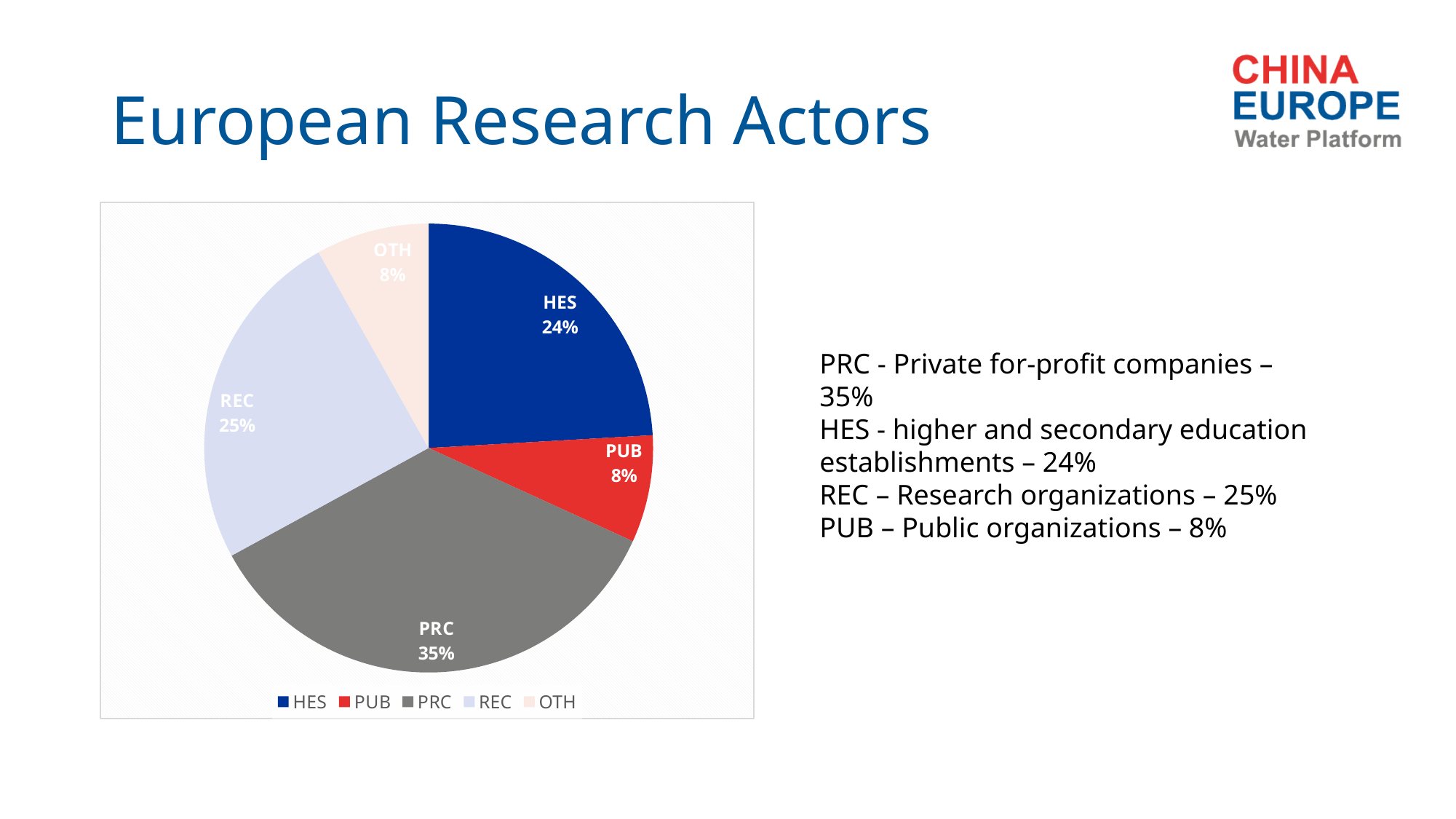
Which category has the largest slice of the pie? PRC What is the difference in percentage points between PRC and HES? 11 Which category is listed first in the legend? HES How many categories does the pie chart show? 5 What is the difference in percentage points between REC and PUB? 17 What kind of chart is shown on the slide? pie chart What share of the pie does PRC have? 35% What share of the pie does REC have? 25% What colour is the PRC slice in the pie chart? grey Which is larger, the HES slice or the PUB slice? HES What share of the pie does PUB have? 8% What share of the pie does HES have? 24%